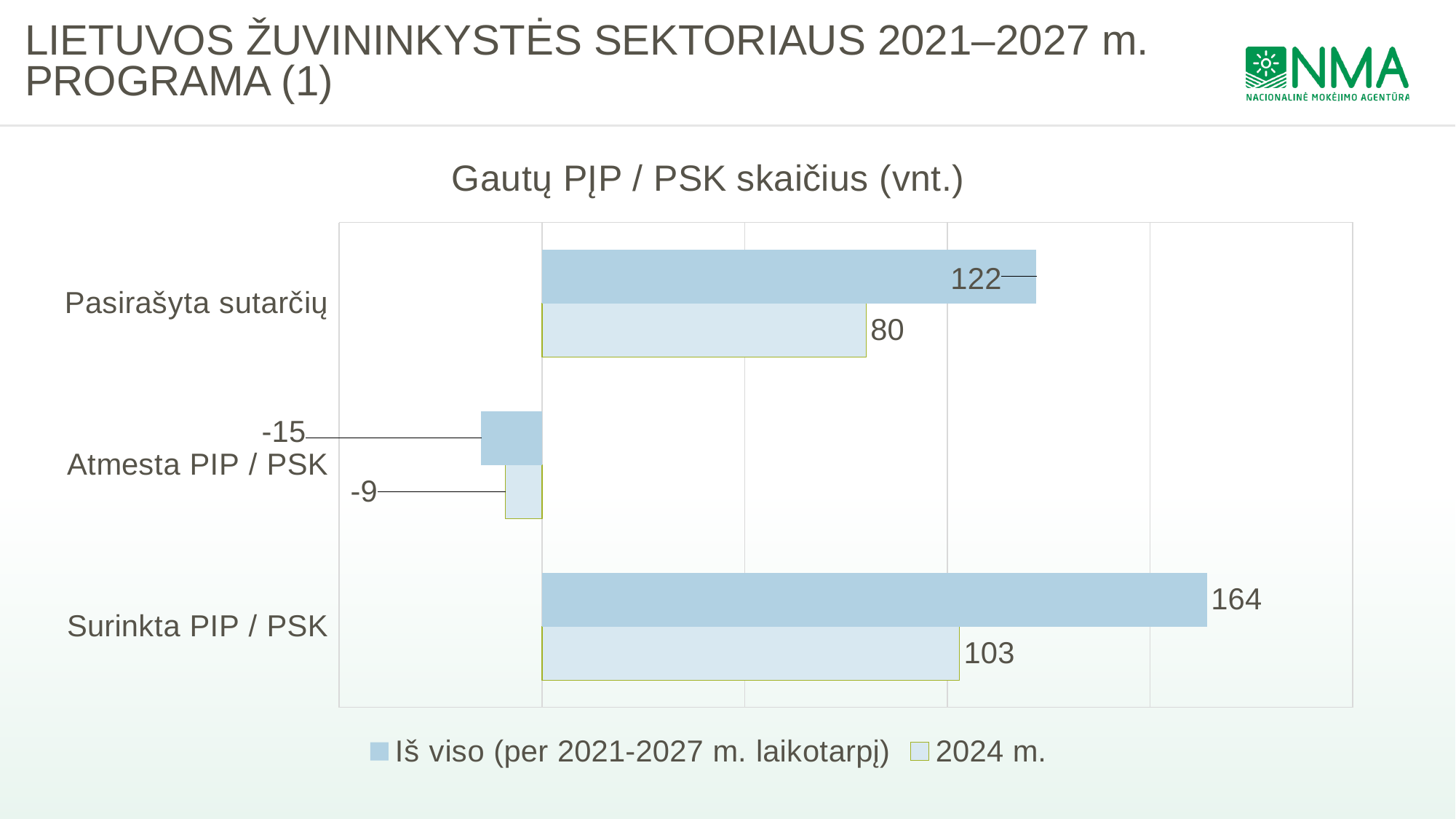
What is the value for Atmesta PIP / PSK in the Iš viso (per 2021-2027 m. laikotarpį) series? -15 What is the difference between the Iš viso (per 2021-2027 m. laikotarpį) and 2024 m. values for Pasirašyta sutarčių? 42 Which category has the highest value in the Iš viso (per 2021-2027 m. laikotarpį) series? Surinkta PIP / PSK What is the value for Pasirašyta sutarčių in the 2024 m. series? 80 How many series does the legend list? 2 What is the value for Surinkta PIP / PSK in the Iš viso (per 2021-2027 m. laikotarpį) series? 164 What is the value for Atmesta PIP / PSK in the 2024 m. series? -9 What is the difference between the Iš viso (per 2021-2027 m. laikotarpį) and 2024 m. values for Surinkta PIP / PSK? 61 Which is larger: the 2024 m. value for Surinkta PIP / PSK or the Iš viso value for Pasirašyta sutarčių? Iš viso value for Pasirašyta sutarčių Which category has the lowest value in the 2024 m. series? Atmesta PIP / PSK What kind of chart is shown on the slide? Bar chart How many categories are shown on the chart? 3